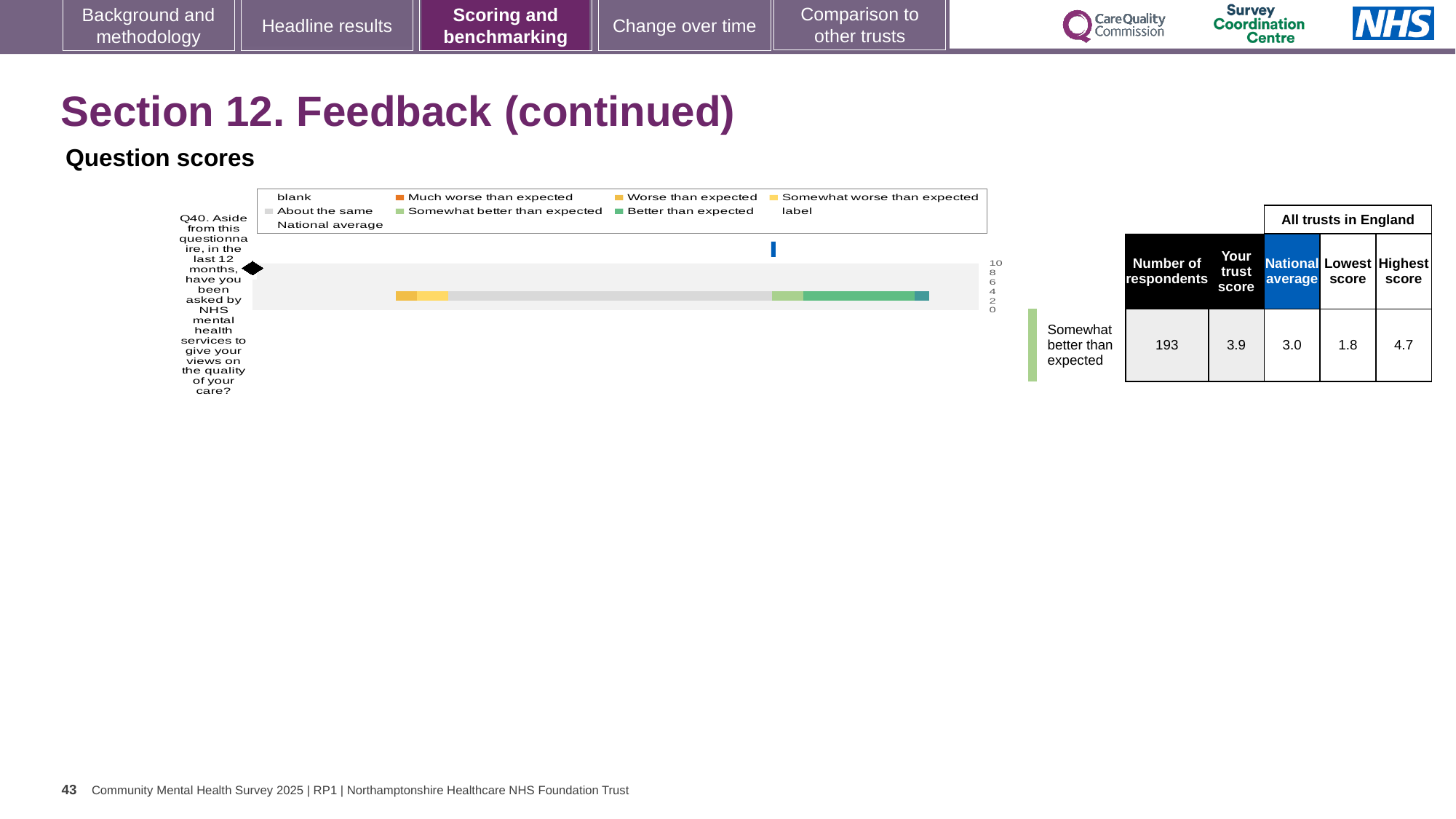
What is the lowest score among all trusts in England for Q40? 1.8 Which benchmarking category does the trust's score for Q40 fall into? Somewhat better than expected What kind of chart is used to show the Q40 question score? bar chart What is the highest score among all trusts in England for Q40? 4.7 How many questions are plotted in the chart? 1 What is the trust's score for Q40? 3.9 How many respondents answered Q40? 193 How many entries does the chart legend list? 9 What is the national average score for Q40? 3.0 What is the difference between the highest and lowest scores among all trusts in England for Q40? 2.9 Which is larger for Q40, the trust's score or the national average? the trust's score What is the difference between the trust's score and the national average for Q40? 0.9